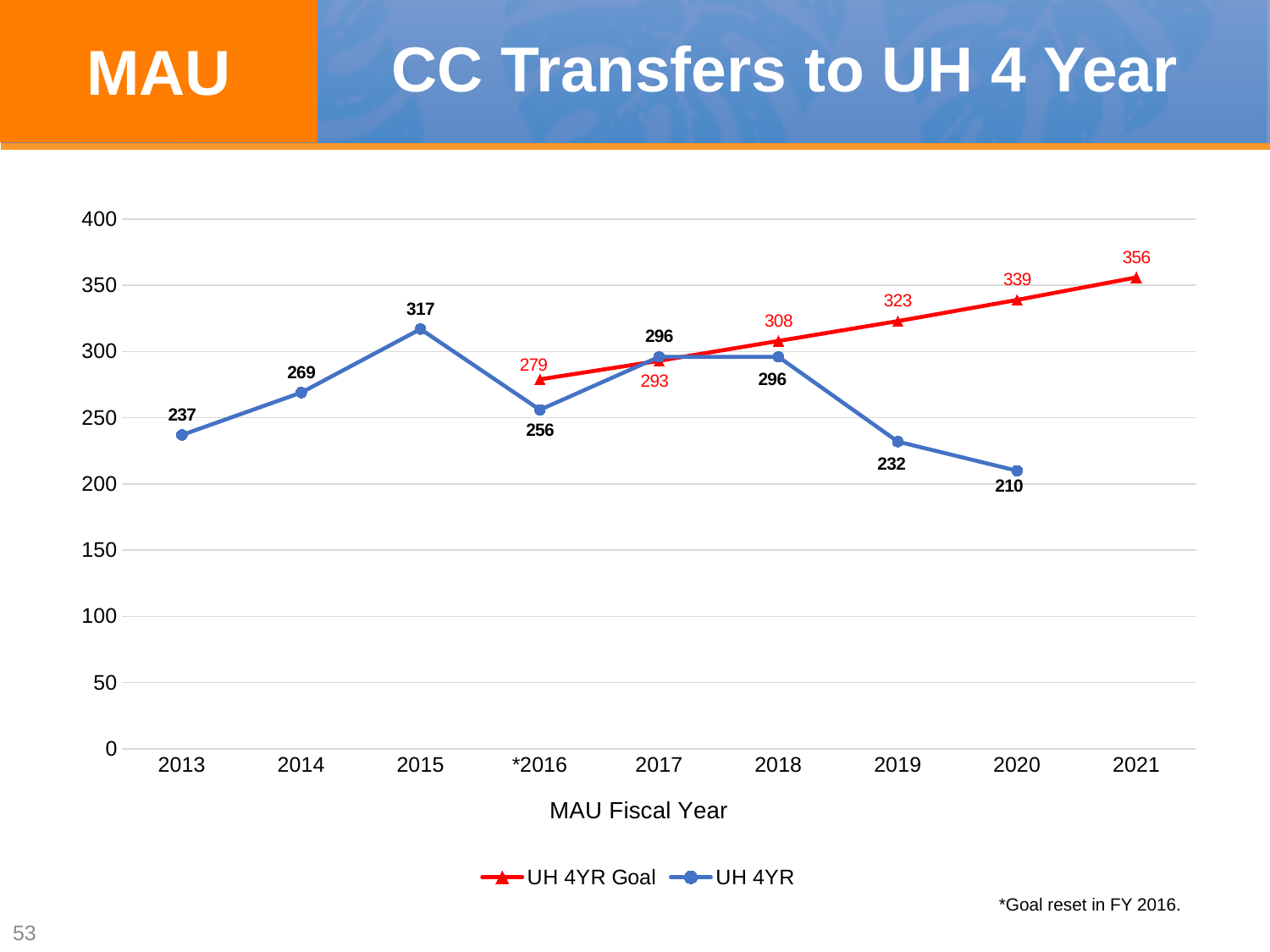
How many series does the legend list? 2 What is the title of the x axis? MAU Fiscal Year What is the UH 4YR value for 2020? 210 Which is larger in 2017, the UH 4YR value or the UH 4YR Goal value? UH 4YR How many years are shown on the x axis? 9 What is the UH 4YR value for 2015? 317 What is the UH 4YR Goal value for 2021? 356 In which year is the UH 4YR series highest? 2015 What type of chart is shown on the slide? Line chart In which year is the UH 4YR series lowest? 2020 Does the UH 4YR Goal series rise or fall from 2016 to 2021? Rise What is the difference between the UH 4YR Goal and the UH 4YR value in 2019? 91